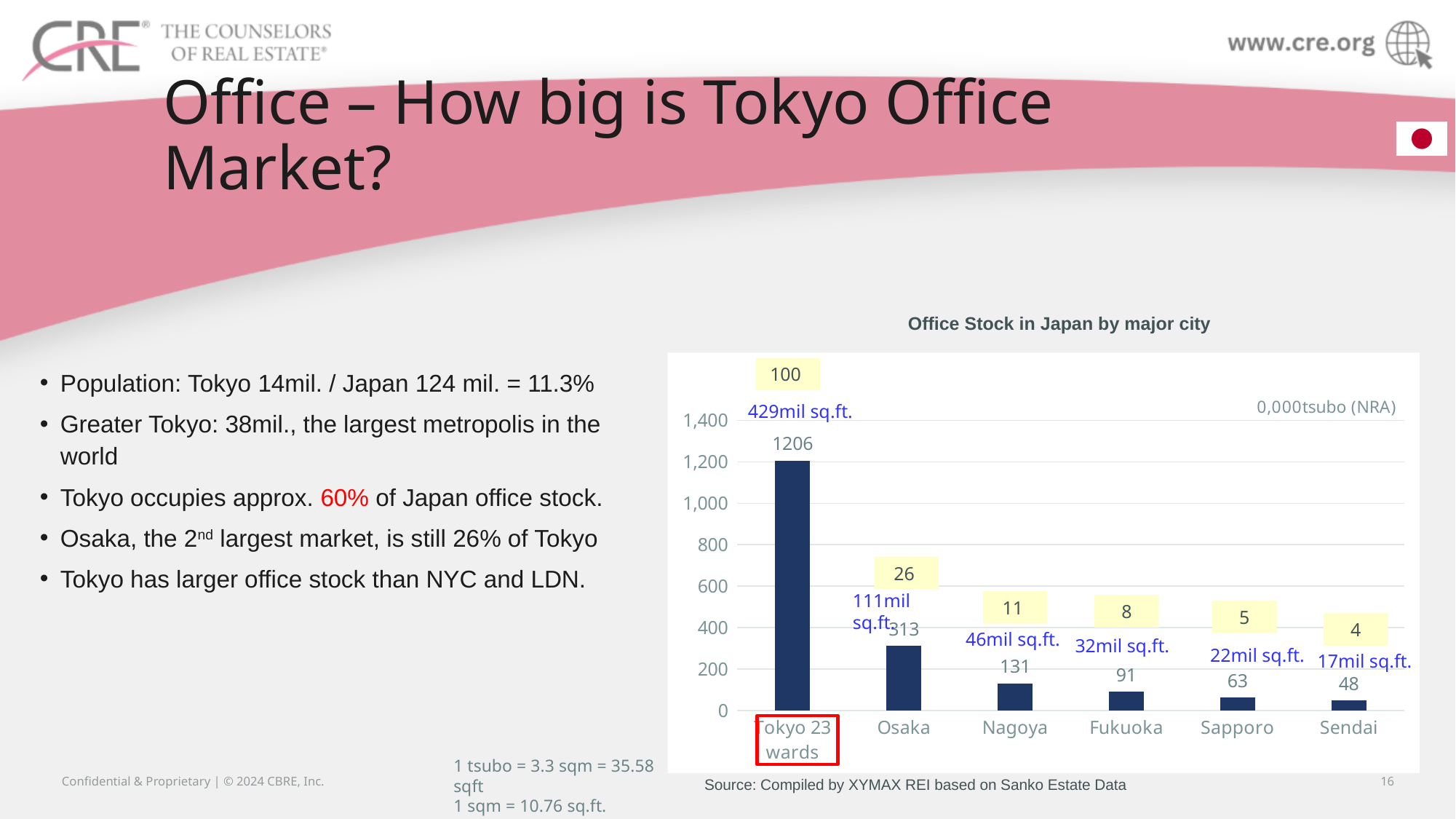
How many cities are shown in the chart? 6 Which city has the highest office stock in the chart? Tokyo 23 wards Which city has the lowest office stock in the chart? Sendai What is the office stock value shown for Sendai? 48 What is the office stock value shown for Osaka? 313 Which city has a larger office stock, Fukuoka or Sapporo? Fukuoka What is the office stock in million sq.ft. shown for Fukuoka? 32mil sq.ft. What type of chart is shown on the slide? bar chart What is the office stock value shown for Nagoya? 131 What is the difference between the office stock values of Tokyo 23 wards and Osaka? 893 Do the bar values rise or fall from left to right across the cities? fall What is the title of the chart on the slide? Office Stock in Japan by major city